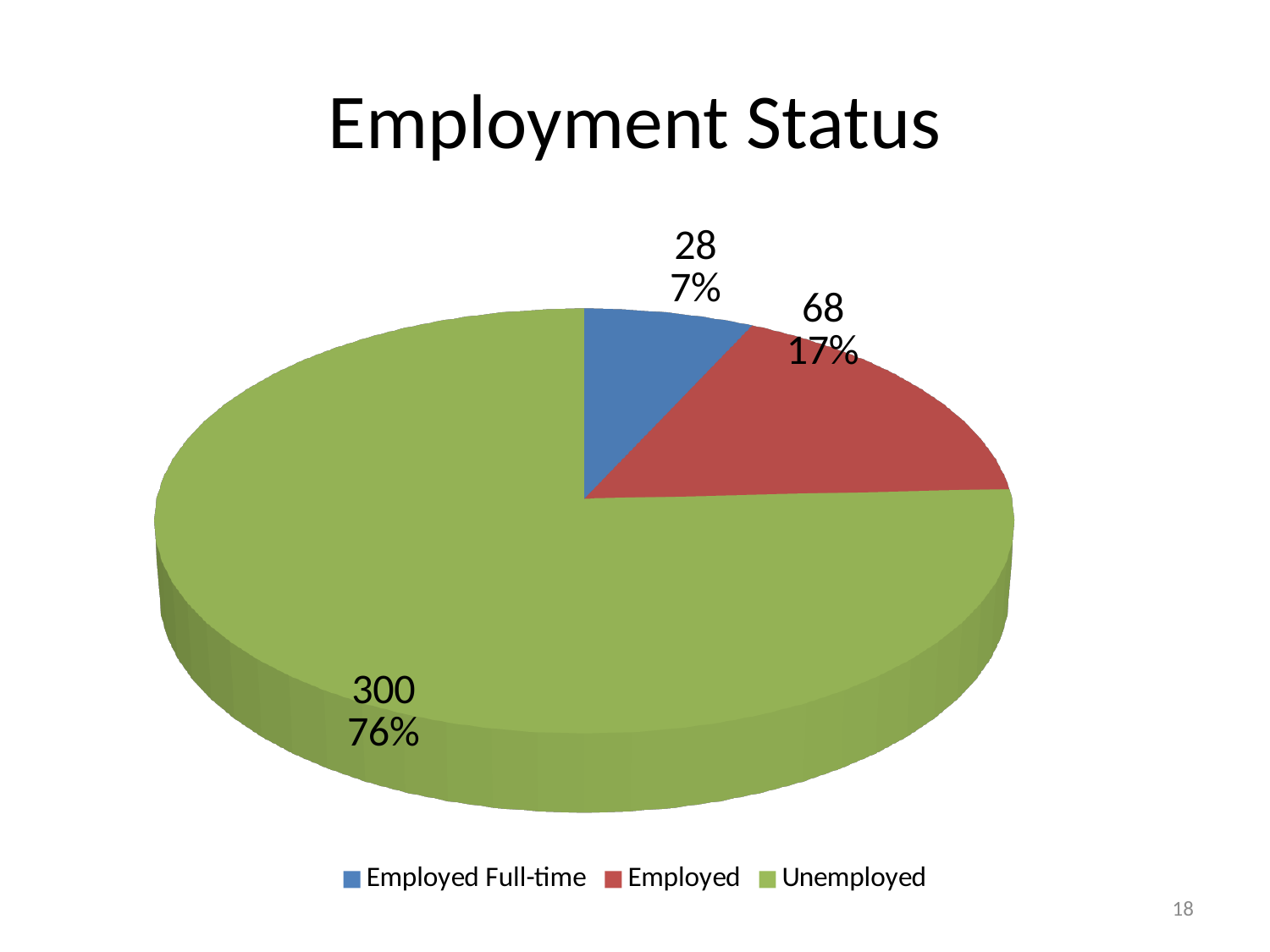
What is the difference between the values for Unemployed and Employed? 232 What is the value for Employed Full-time? 28 What share of the pie does Employed represent? 17% Which is larger, the value for Employed or the value for Employed Full-time? Employed What is the value for Unemployed? 300 How many categories does the pie chart have? 3 Which category has the smallest slice? Employed Full-time What share of the pie does Employed Full-time represent? 7% What is the value for Employed? 68 Which category has the largest slice? Unemployed What type of chart is shown on the slide? pie chart What share of the pie does Unemployed represent? 76%